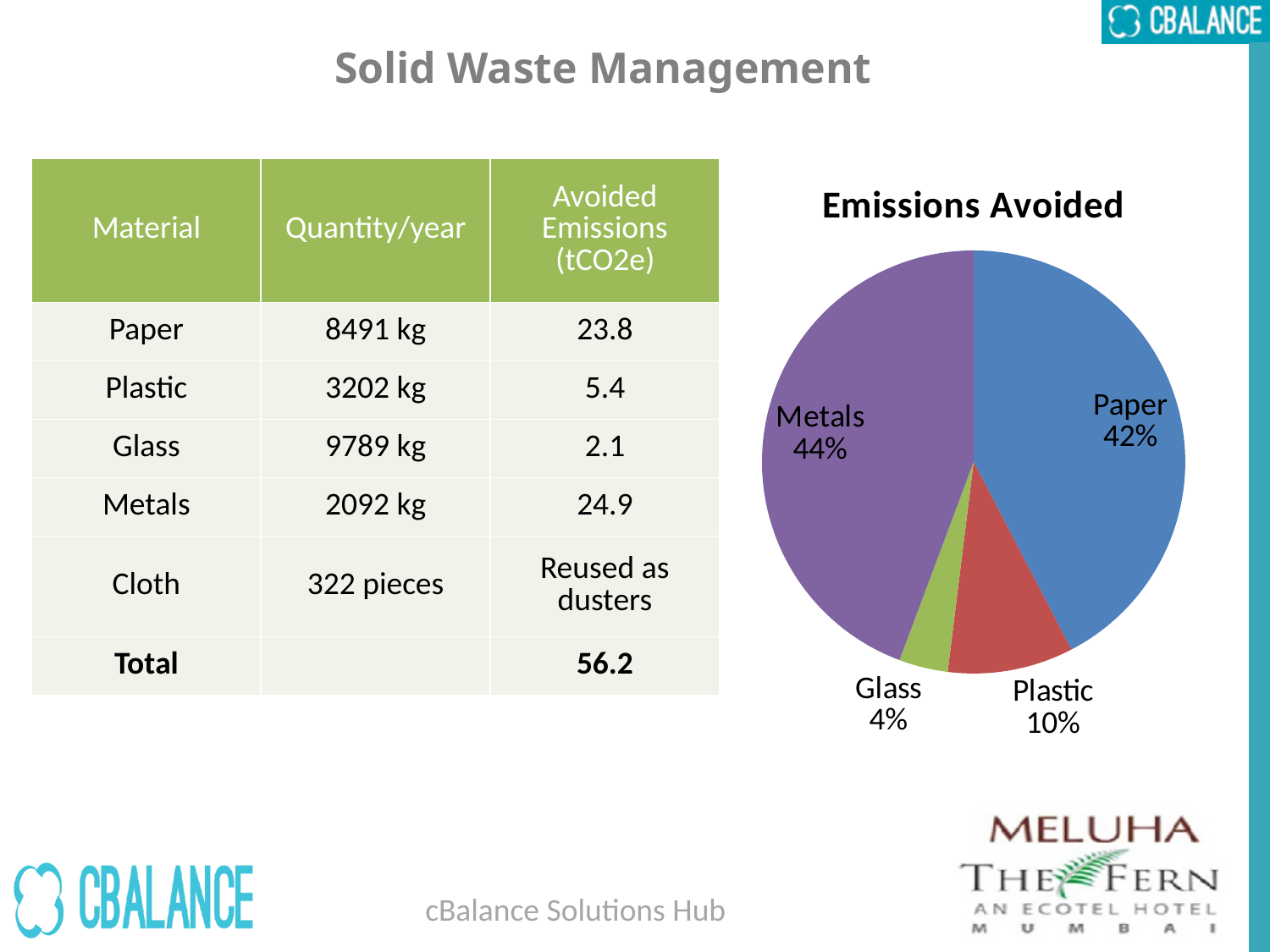
What type of chart is shown on the slide? pie chart In the Emissions Avoided pie chart, what colour is the Metals slice? purple In the Emissions Avoided pie chart, which is larger, the Plastic slice or the Glass slice? Plastic What share of the Emissions Avoided pie does Glass account for? 4% What is the title of the chart? Emissions Avoided What share of the Emissions Avoided pie does Metals account for? 44% Which material has the smallest slice in the Emissions Avoided pie chart? Glass In the Emissions Avoided pie chart, what is the difference in percentage points between Metals and Paper? 2 percentage points How many slices does the Emissions Avoided pie chart have? 4 What share of the Emissions Avoided pie does Paper account for? 42% Which material has the largest slice in the Emissions Avoided pie chart? Metals